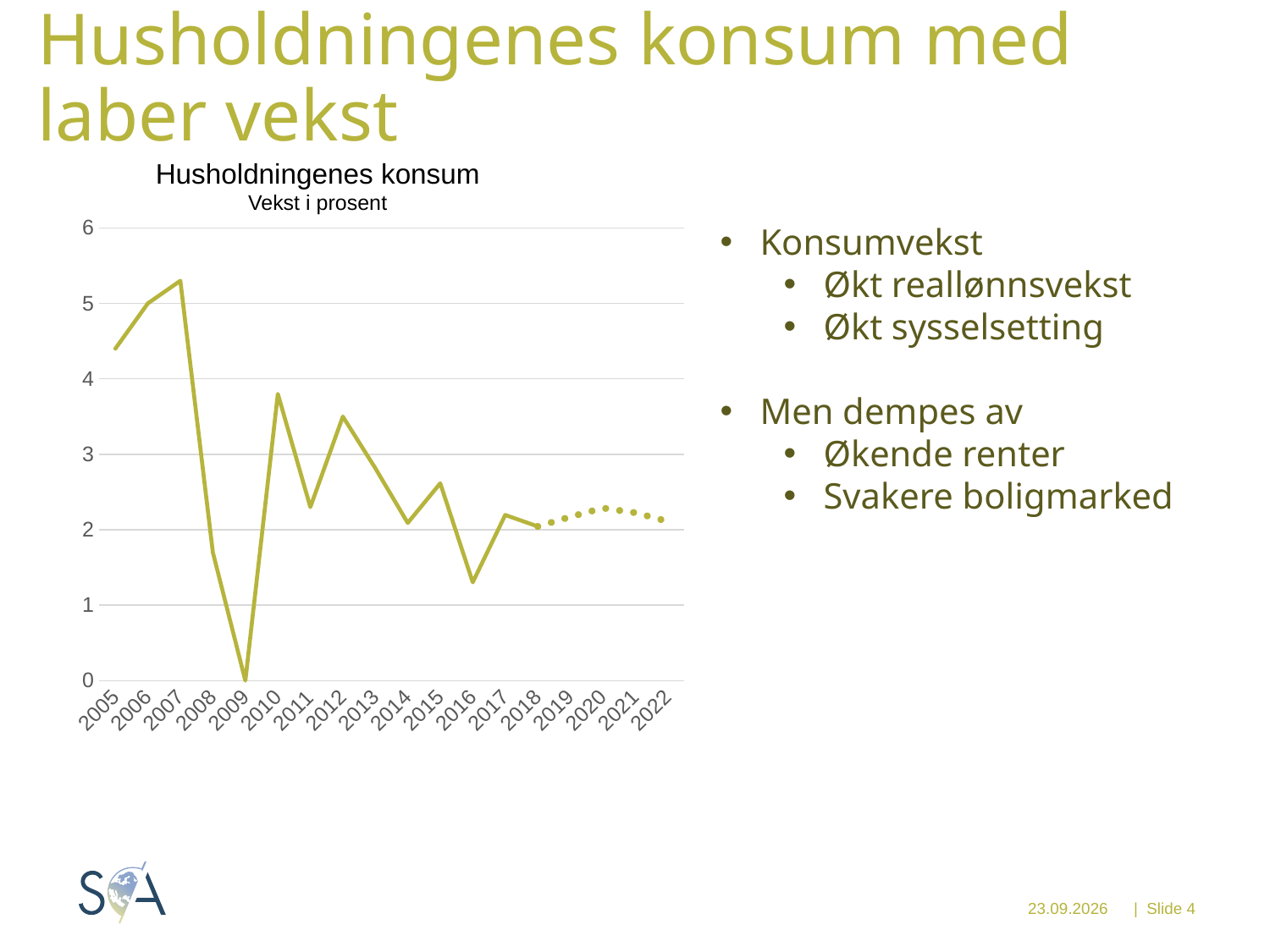
Do the values rise or fall from 2005 to 2007? rise Is the value for 2010 greater or less than 3? greater Do the values rise or fall from 2007 to 2009? fall What is the title of the chart? Husholdningenes konsum Which year has the larger value, 2006 or 2008? 2006 Is the value for 2016 greater or less than 2? less What is the subtitle of the chart, describing the unit of the values? Vekst i prosent How many years are shown on the x axis of the chart? 18 What kind of chart is shown on the slide? line chart Which year has the lowest value in the chart? 2009 Which year has the highest value in the chart? 2007 Is the value for 2007 greater or less than 5? greater